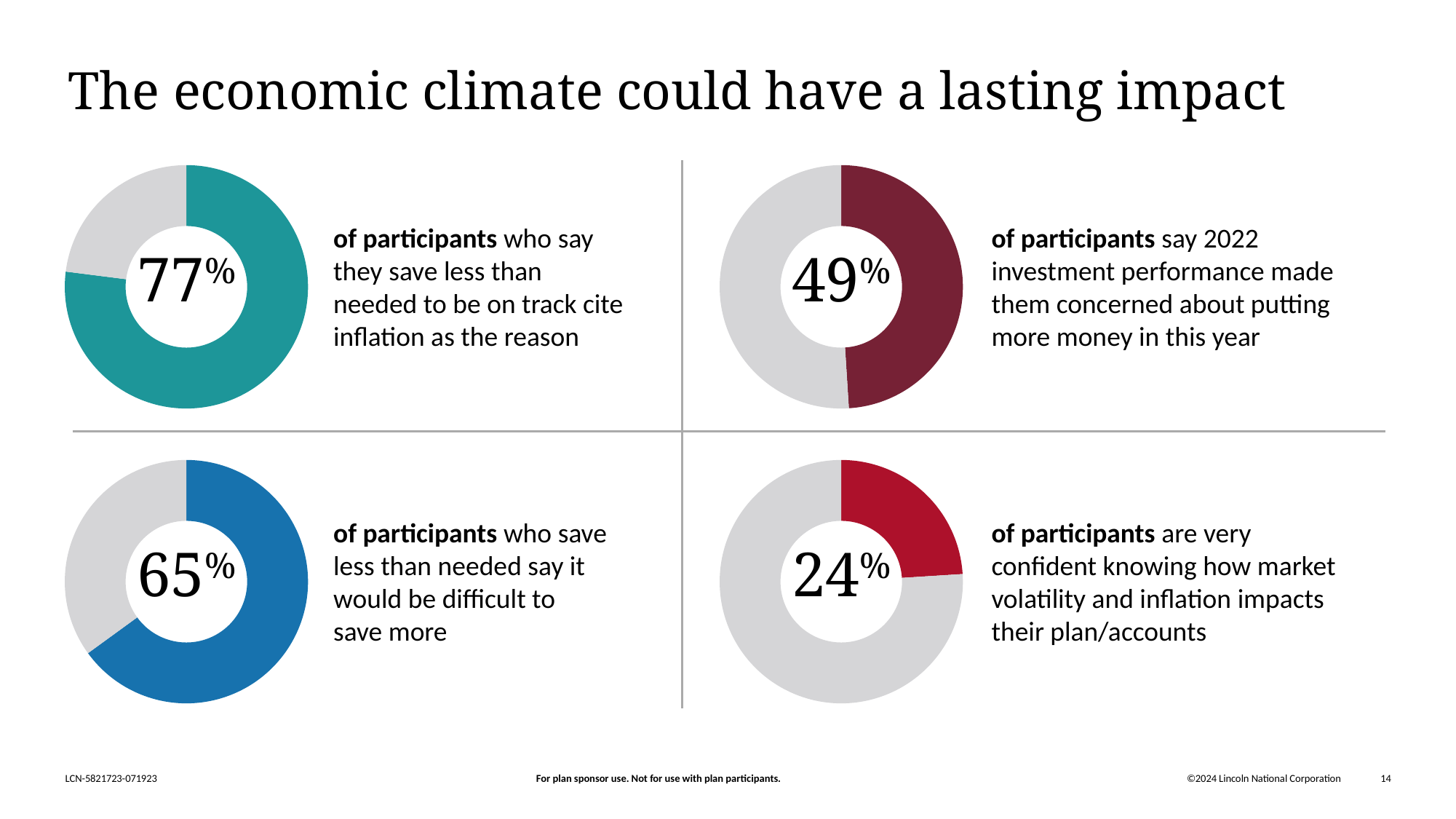
Which of the four donut charts shows the lowest percentage? The bottom-right chart (24%) What kind of chart is used to display each of the four statistics on the slide? Donut chart What is the difference between the percentage in the top-left chart (77%) and the percentage in the top-right chart (49%)? 28 percentage points What percentage is shown in the top-left donut chart about participants citing inflation as the reason they save less than needed? 77% What percentage of participants say 2022 investment performance made them concerned about putting more money in this year, per the top-right chart? 49% What colour is the filled segment of the top-right donut chart showing 49%? Maroon (dark red) How many donut charts are shown on the slide? 4 According to the bottom-right chart, what percentage of participants are very confident knowing how market volatility and inflation impacts their plan/accounts? 24% Which is larger: the percentage in the bottom-left chart or the percentage in the bottom-right chart? The bottom-left chart (65%) In the bottom-left chart, what percentage of participants who save less than needed say it would be difficult to save more? 65% Which of the four donut charts shows the highest percentage? The top-left chart (77%) What is the difference between the bottom-left chart's 65% and the bottom-right chart's 24%? 41 percentage points